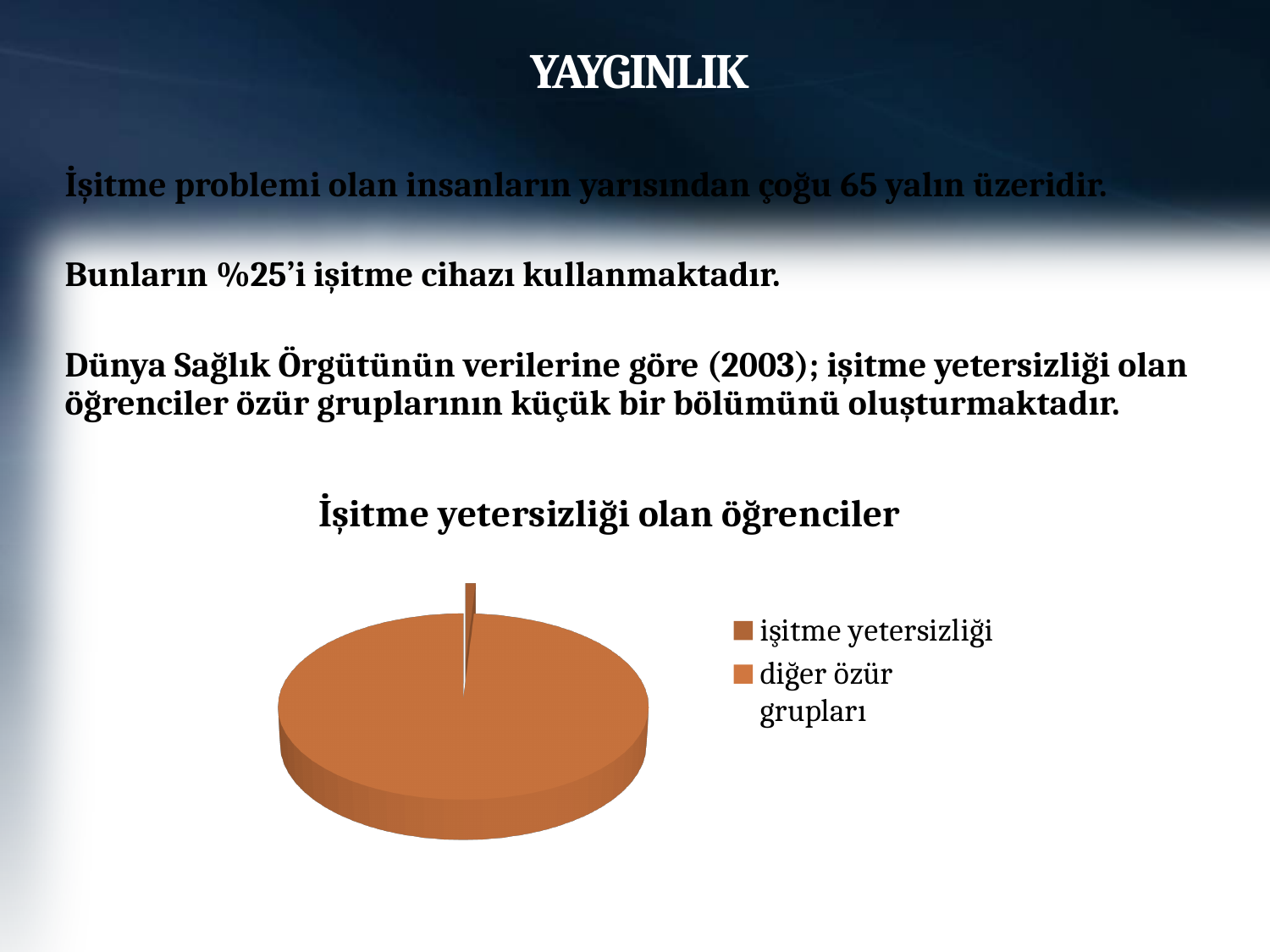
How many slices does the pie chart have? 2 Which slice of the pie chart is the largest? diğer özür grupları Which is larger in the pie chart, the slice for işitme yetersizliği or the slice for diğer özür grupları? diğer özür grupları How many entries does the chart's legend list? 2 What is the title of the chart on the slide? İşitme yetersizliği olan öğrenciler Which slice of the pie chart is the smallest? işitme yetersizliği What are the two categories listed in the chart's legend? işitme yetersizliği and diğer özür grupları What kind of chart is shown on the slide? pie chart